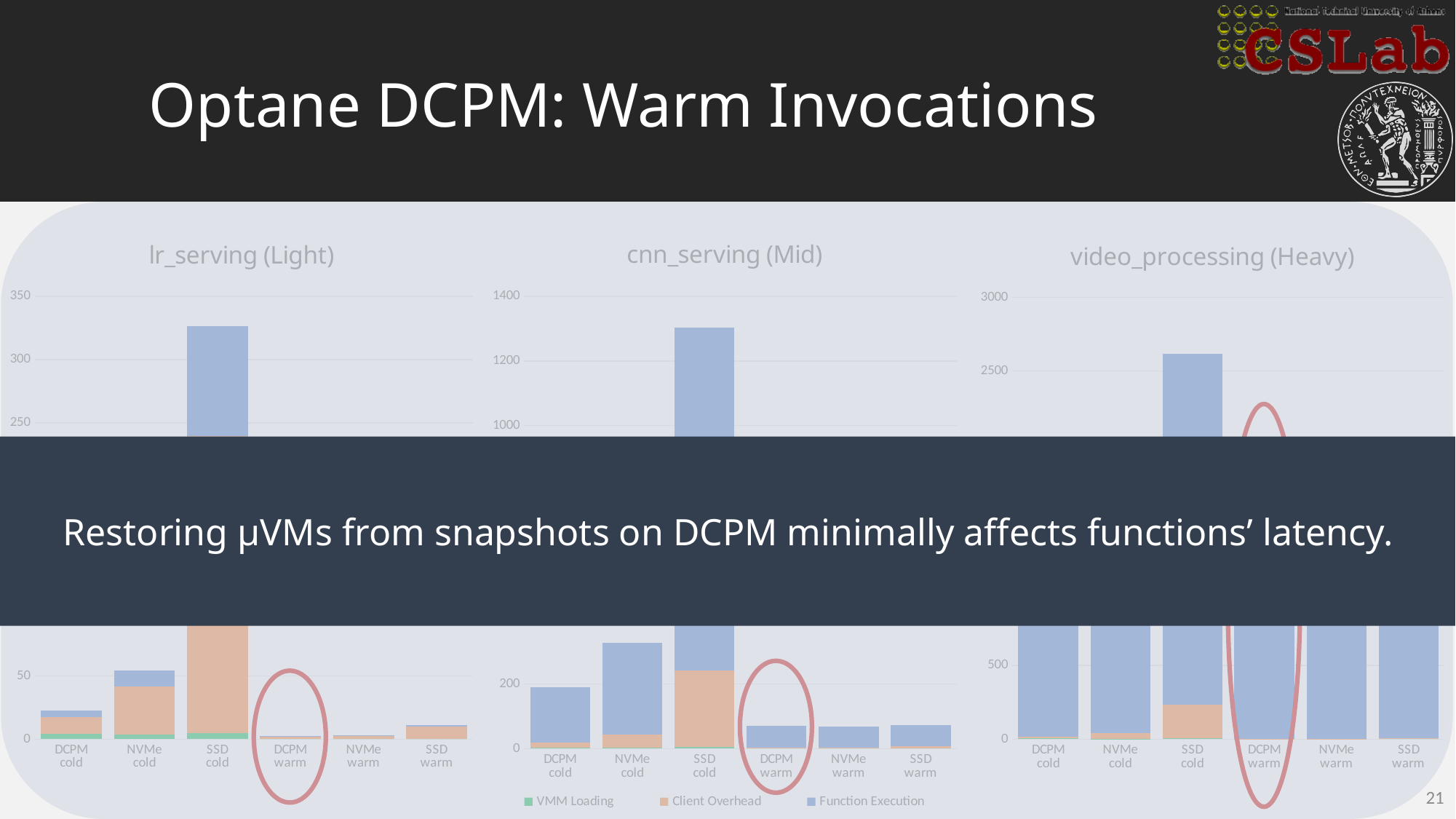
In the cnn_serving (Mid) chart, which category has the tallest bar? SSD cold In the lr_serving (Light) chart, which category has the tallest bar? SSD cold In the video_processing (Heavy) chart, is the total for SSD cold greater or less than 2500? greater Which legend entry is shown in orange on the charts? Client Overhead How many series does the legend list for the charts on this slide? 3 In the lr_serving (Light) chart, is the total for SSD cold greater or less than 300? greater How many categories are shown on the x axis of the cnn_serving (Mid) chart? 6 In the cnn_serving (Mid) chart, which is larger, the bar for NVMe cold or the bar for DCPM cold? NVMe cold What kind of chart is the lr_serving (Light) chart? bar chart In the lr_serving (Light) chart, is the total for DCPM cold greater or less than 50? less In the video_processing (Heavy) chart, which category has the tallest bar? SSD cold